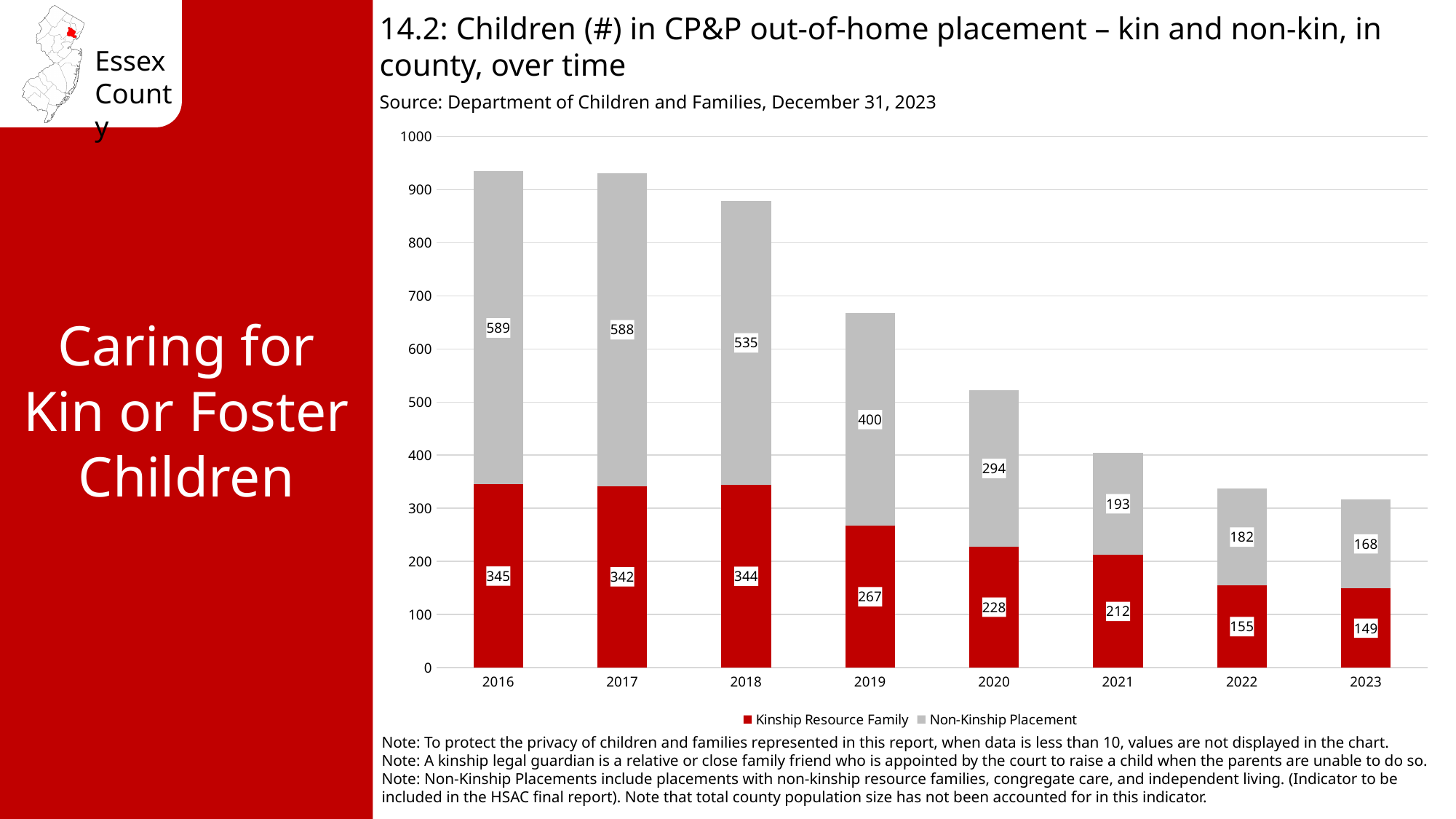
What is the Non-Kinship Placement value for 2020? 294 Which year has the lowest Kinship Resource Family value? 2023 In 2021, which is larger: Kinship Resource Family or Non-Kinship Placement? Kinship Resource Family How many series does the legend list? 2 What is the Kinship Resource Family value for 2023? 149 What is the difference between the Non-Kinship Placement values for 2018 and 2019? 135 How many years are shown on the x axis? 8 What is the Kinship Resource Family value for 2019? 267 What kind of chart is shown on the slide? Stacked bar chart What is the total of the stacked bar for 2016? 934 What is the total of the stacked bar for 2023? 317 Which year has the highest Non-Kinship Placement value? 2016